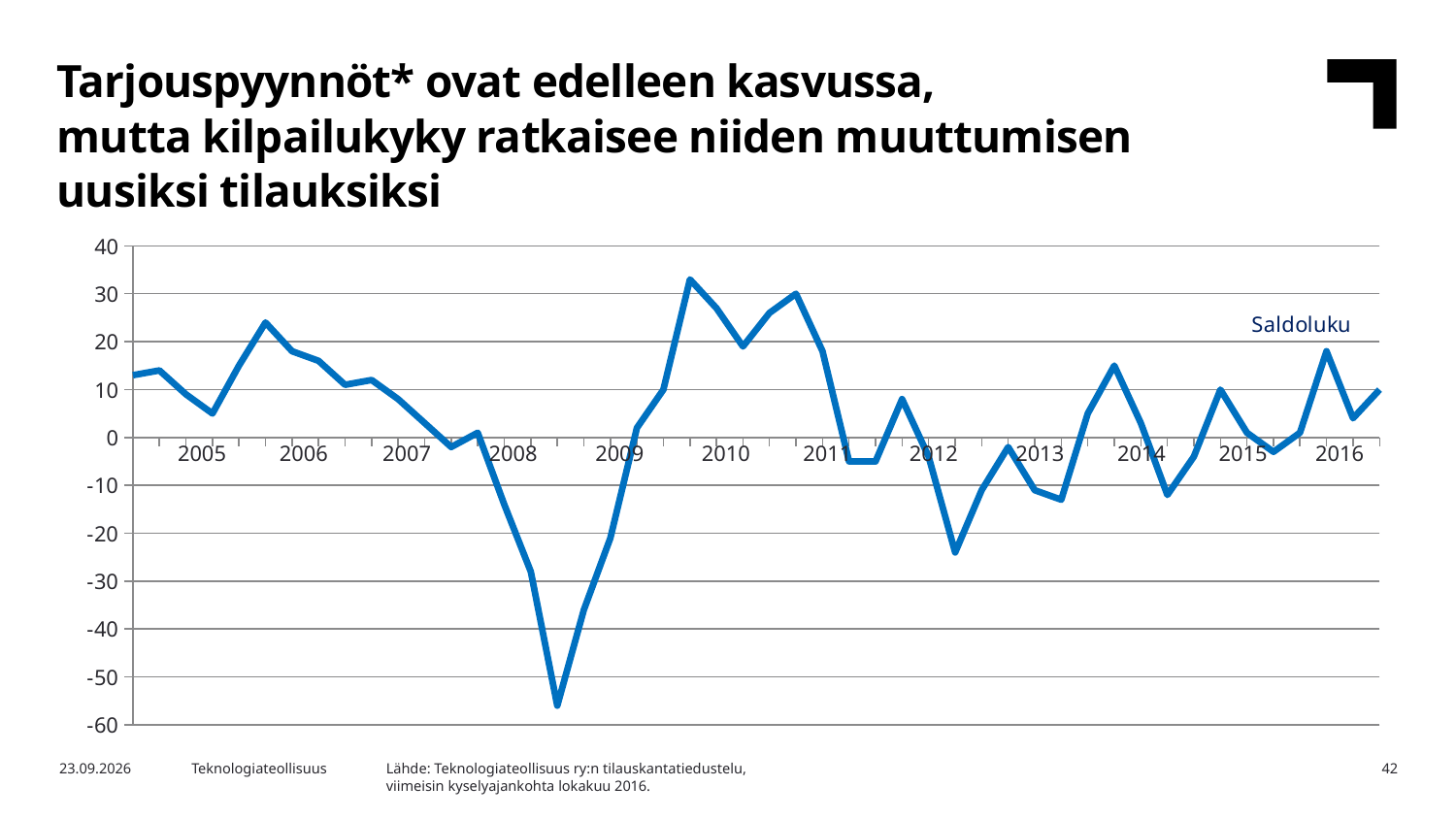
Is the peak value reached in 2005 greater or less than 20? less How many years are labelled on the x axis? 12 What kind of chart is shown on the slide? line chart Is the lowest point of the line, in 2008, greater or less than -50? less In which year does the line reach its lowest value? 2009 What is the name of the series shown on the chart? Saldoluku How many series does the chart plot? 1 Does the line rise or fall from its 2008 trough to its peak in 2009? rise Is the lowest value reached in 2012 greater or less than -20? less What are the minimum and maximum values shown on the y axis? -60 and 40